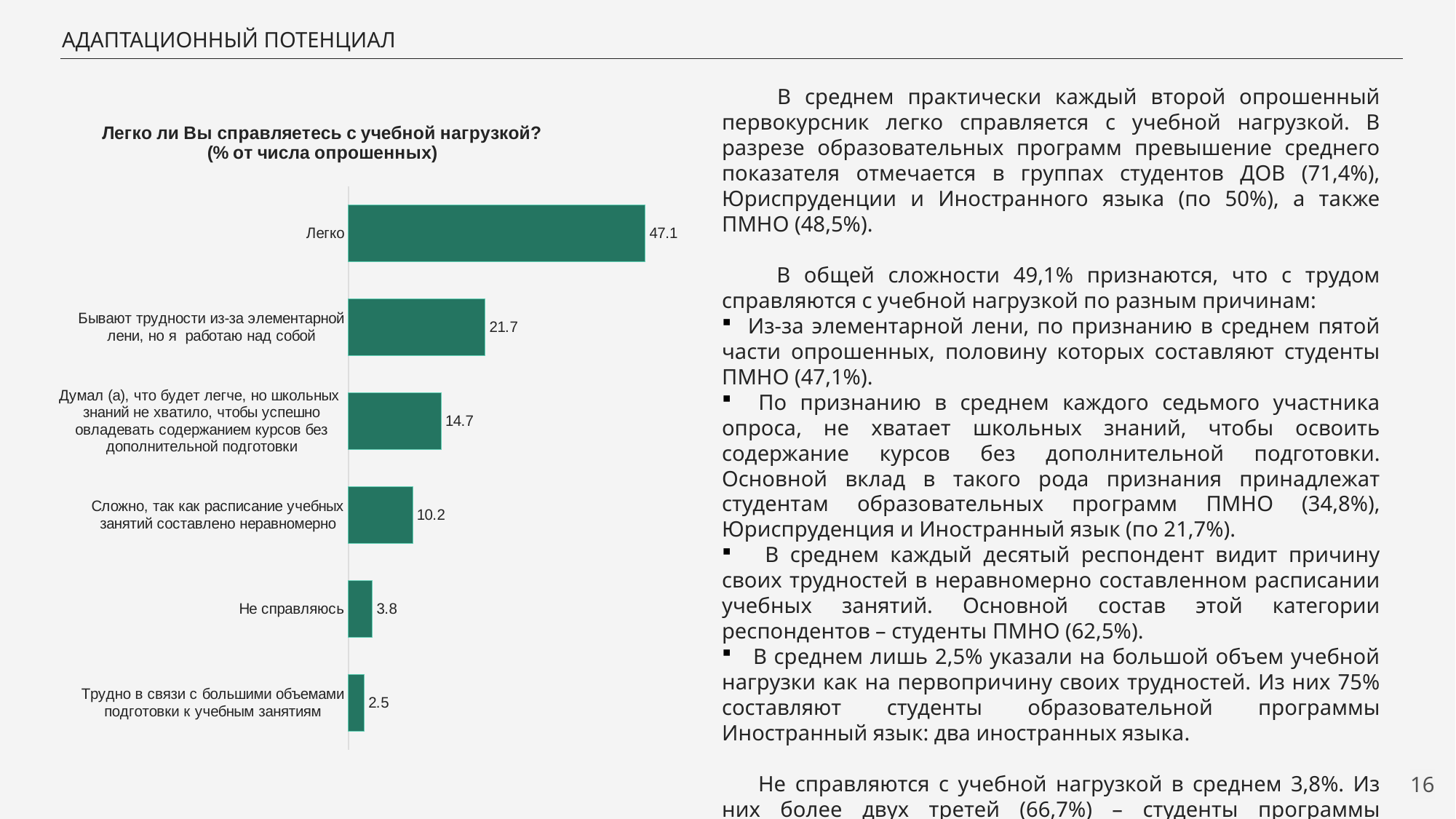
What is the difference between the values for "Не справляюсь" and "Трудно в связи с большими объемами подготовки к учебным занятиям"? 1.3 What value is shown for "Сложно, так как расписание учебных занятий составлено неравномерно"? 10.2 How many categories are shown in the chart? 6 What value is shown for "Трудно в связи с большими объемами подготовки к учебным занятиям"? 2.5 Which category has the highest value? Легко What is the title of the chart? Легко ли Вы справляетесь с учебной нагрузкой? (% от числа опрошенных) Which category has the lowest value? Трудно в связи с большими объемами подготовки к учебным занятиям What is the difference between the values for "Легко" and "Бывают трудности из-за элементарной лени, но я работаю над собой"? 25.4 What value is shown for the category "Легко"? 47.1 What value is shown for "Не справляюсь"? 3.8 What type of chart is shown on the slide? Bar chart Which is larger: the value for "Думал(а), что будет легче, но школьных знаний не хватило..." or the value for "Сложно, так как расписание учебных занятий составлено неравномерно"? Думал(а), что будет легче, но школьных знаний не хватило...